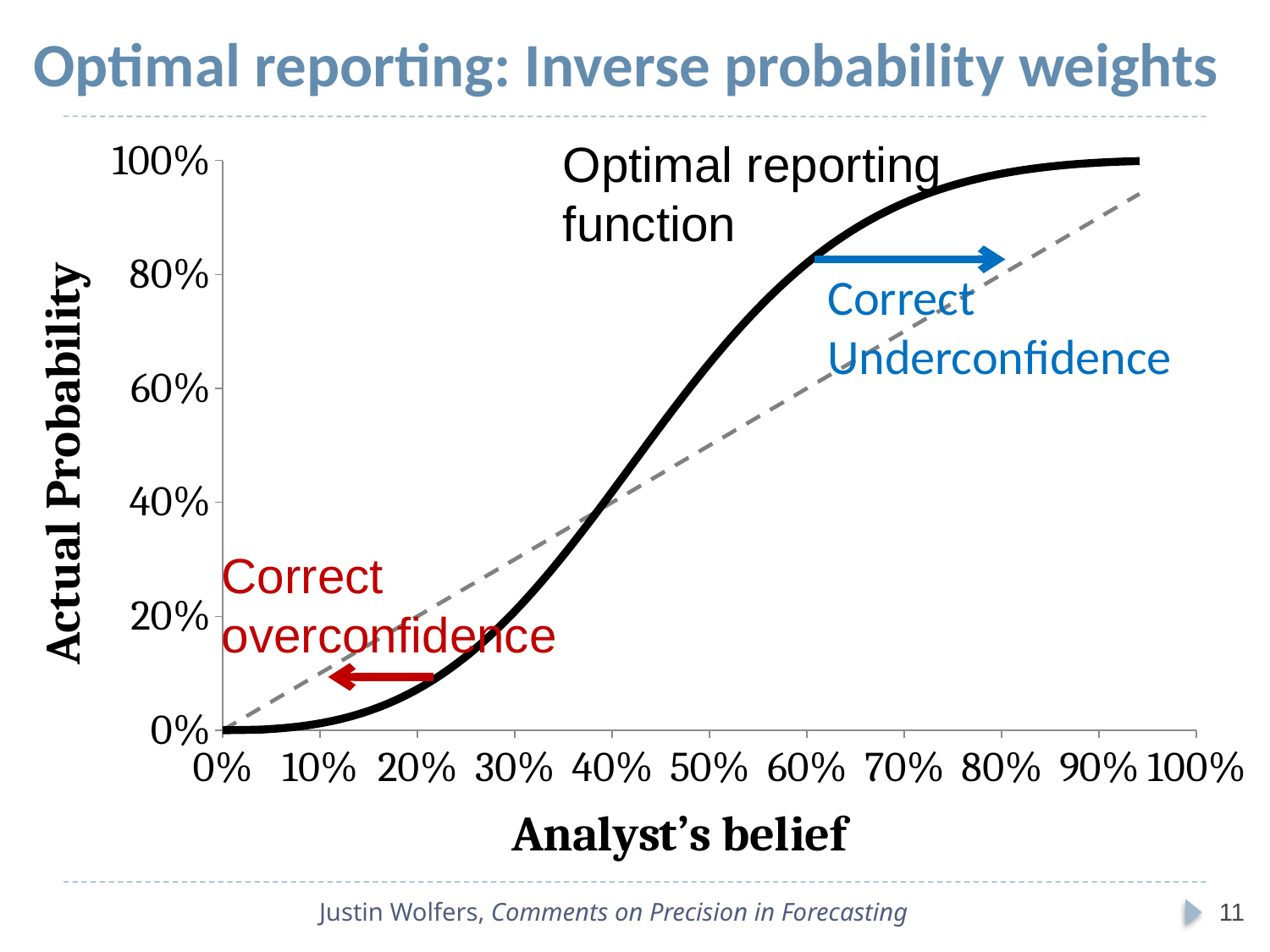
What is the title of the slide's chart? Optimal reporting: Inverse probability weights At an analyst's belief of 20%, which is larger: the optimal reporting function or the dashed 45-degree line? The dashed 45-degree line Is the actual probability on the optimal reporting function at an analyst's belief of 60% greater or less than 60%? greater What is the label of the y axis? Actual Probability What kind of chart is shown on the slide? Line chart Does the optimal reporting function rise or fall as the analyst's belief increases from 0% to 100%? Rise Is the actual probability on the optimal reporting function at an analyst's belief of 10% greater or less than 20%? less Is the actual probability on the optimal reporting function at an analyst's belief of 80% greater or less than 80%? greater What is the label of the x axis? Analyst's belief At an analyst's belief of 70%, which is larger: the optimal reporting function or the dashed 45-degree line? The optimal reporting function What is the actual probability on the optimal reporting function when the analyst's belief is 0%? 0%